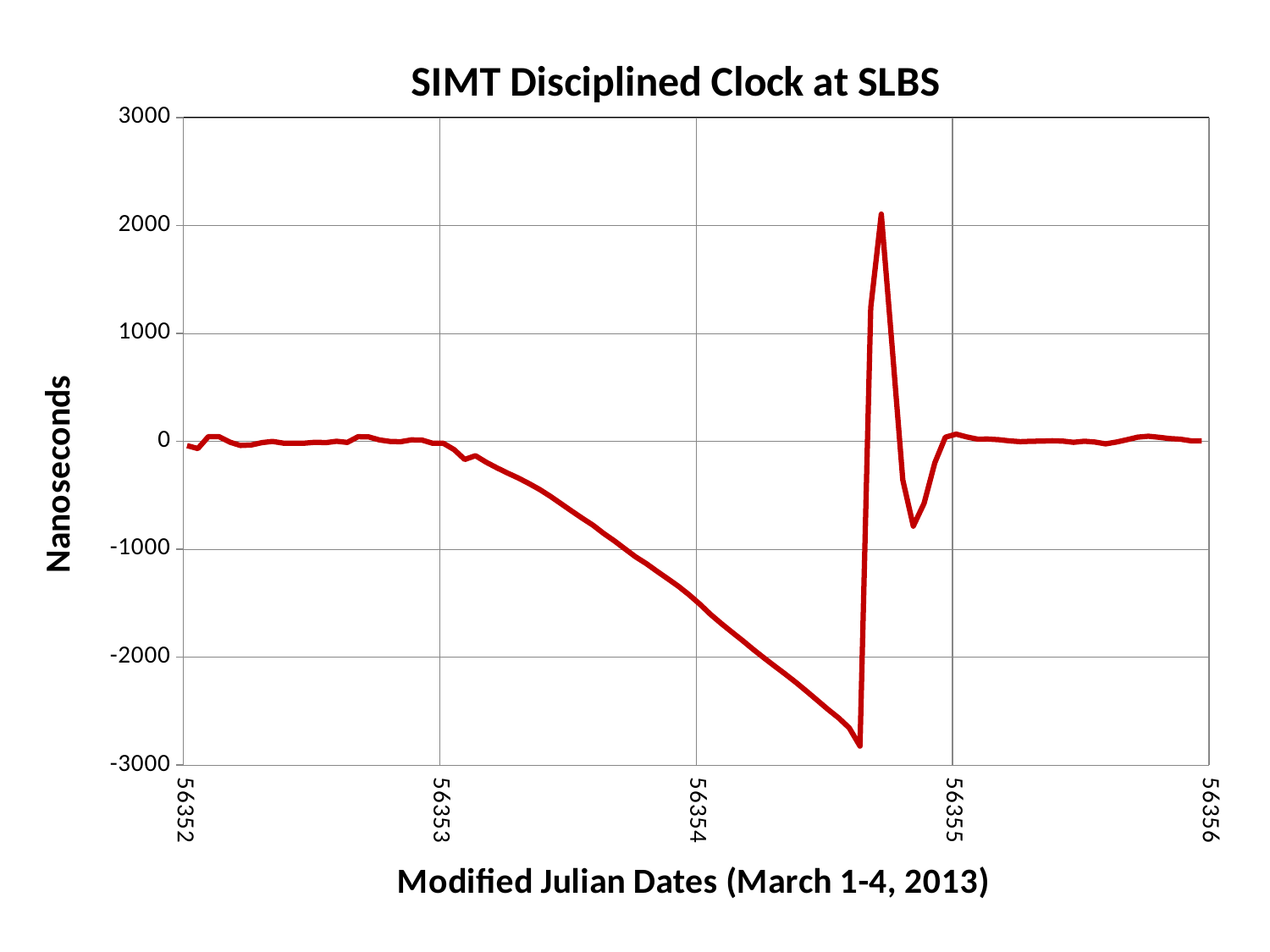
How many labelled tick marks are there on the x axis? 5 Does the line rise or fall between 56353 and 56354 on the x axis? fall Is the value at 56352 greater or less than 1000? less What kind of chart is shown on the slide? line chart Is the lowest point of the line greater or less than -2000? less What is the label on the vertical axis of the chart? Nanoseconds What is the title of the chart? SIMT Disciplined Clock at SLBS Is the value at 56355 greater or less than 1000? less